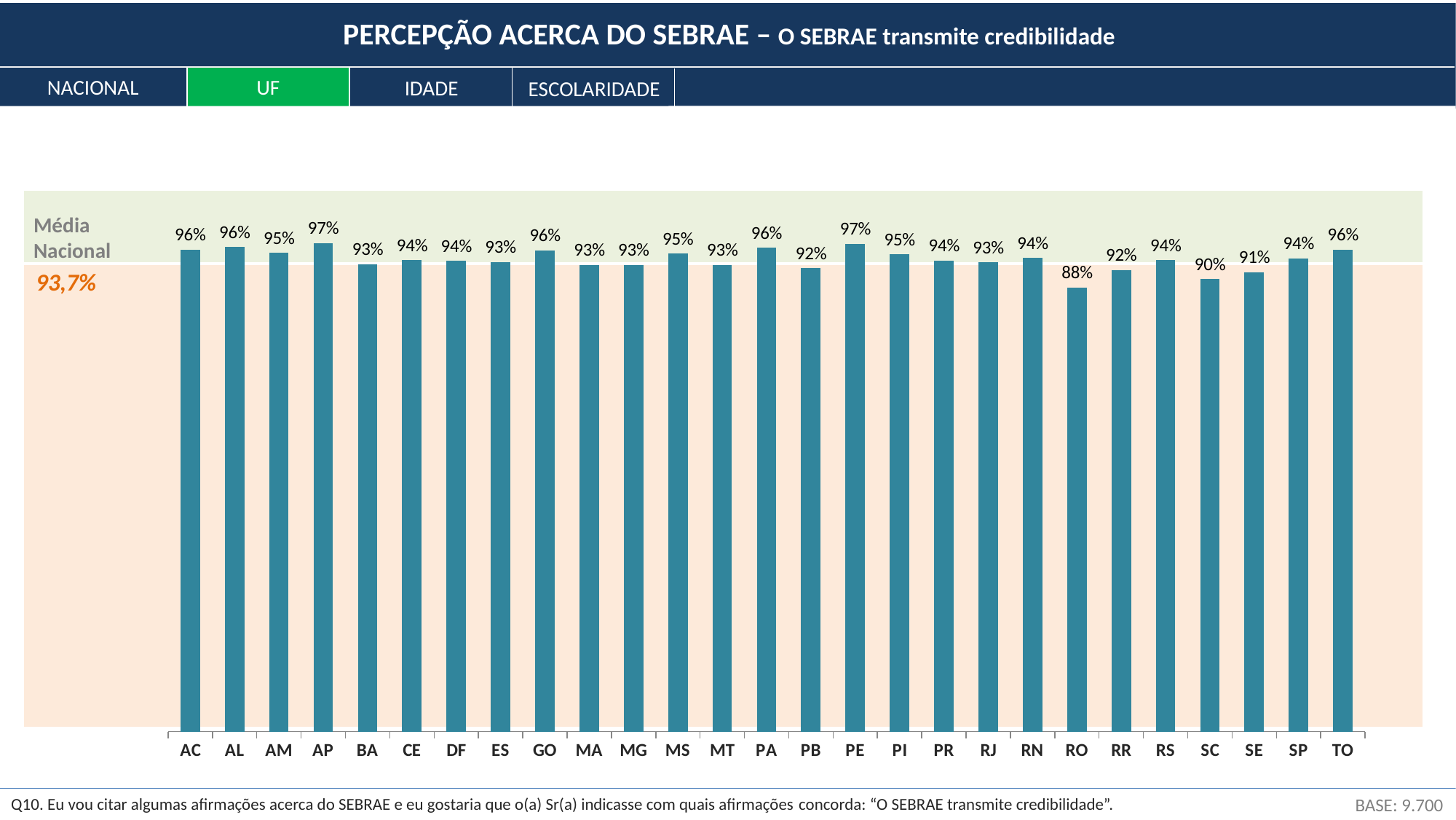
Which UF has the lowest value? RO What is the difference between the values for SC and SE? 1% What is the difference between the values for AP and RO? 9% Which has a larger value, GO or PB? GO What is the value for SP? 94% Which has a larger value, RO or SC? SC What is the value for AM? 95% What is the value for RO? 88% What is the Média Nacional value shown on the chart? 93,7% What kind of chart is shown on the slide? Bar chart How many UFs are shown on the x axis? 27 What is the value for PE? 97%